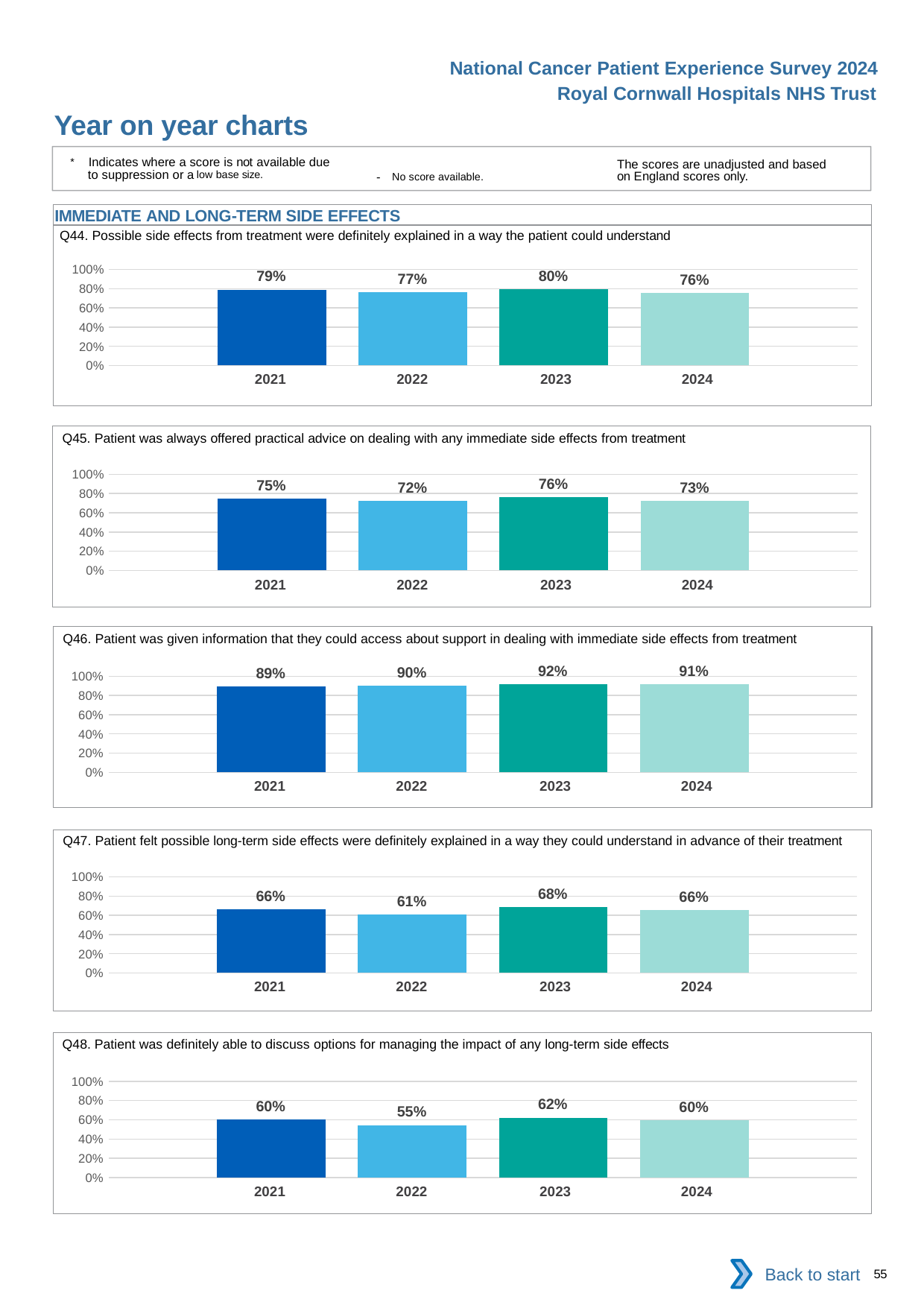
What type of chart is the Q48 chart? Bar chart In the Q44 chart, what is the value for 2023? 80% In the Q46 chart, which year has the highest value? 2023 In the Q45 chart, what is the difference between the 2023 and 2022 values? 4 percentage points In the Q48 chart, what is the difference between the 2023 and 2022 values? 7 percentage points In the Q48 chart, which year has the lowest value? 2022 In the Q47 chart, what is the value for 2024? 66% In the Q47 chart, which is larger, the value for 2021 or the value for 2022? 2021 In the Q46 chart, what is the value for 2021? 89% In the Q45 chart, what is the value for 2022? 72% How many years are shown on the x axis of the Q44 chart? 4 In the Q44 chart, which year has the lowest value? 2024